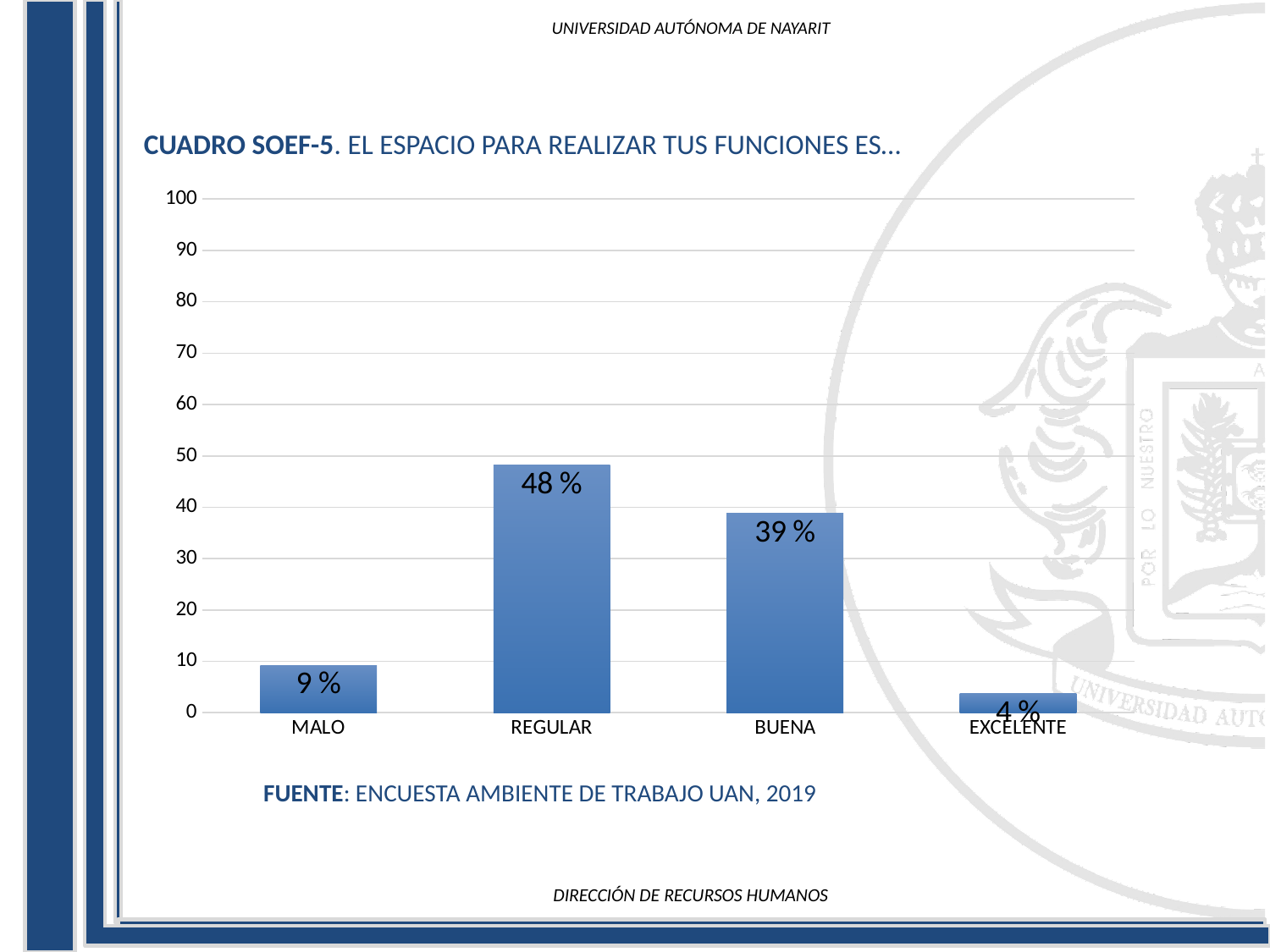
Which category has the highest value? REGULAR What is the value for REGULAR? 48 % Which is larger, the value for MALO or the value for EXCELENTE? MALO What is the value for MALO? 9 % What is the value for EXCELENTE? 4 % What kind of chart is shown on the slide? bar chart Which category has the lowest value? EXCELENTE Is the value for BUENA greater or less than 30? greater What is the difference between the values for REGULAR and BUENA? 9 % How many categories are shown on the x axis? 4 What is the source cited below the chart? ENCUESTA AMBIENTE DE TRABAJO UAN, 2019 What is the value for BUENA? 39 %